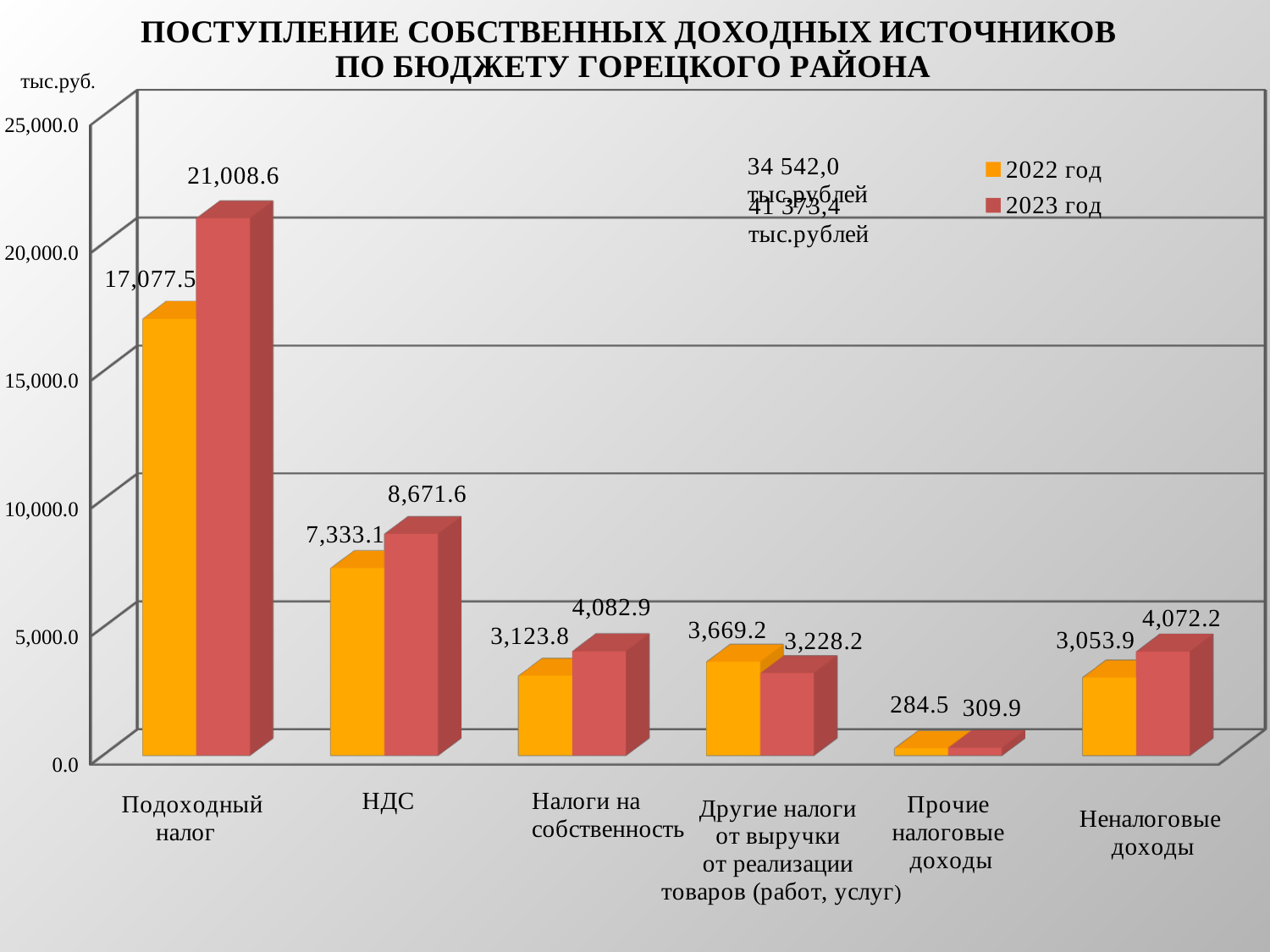
What is the value for Подоходный налог in the 2022 год series? 17,077.5 For Другие налоги от выручки от реализации товаров (работ, услуг), which series has the larger value, 2022 год or 2023 год? 2022 год Which category has the highest value in the 2023 год series? Подоходный налог What is the value for НДС in the 2023 год series? 8,671.6 Which category has the lowest value in the 2022 год series? Прочие налоговые доходы How many series does the legend list? 2 What is the value for Прочие налоговые доходы in the 2022 год series? 284.5 What is the value for Неналоговые доходы in the 2023 год series? 4,072.2 What is the difference between the 2023 год and 2022 год values for Подоходный налог? 3,931.1 How many categories are shown on the x axis? 6 What kind of chart is shown on the slide? Bar chart What is the difference between the 2022 год and 2023 год values for Другие налоги от выручки от реализации товаров (работ, услуг)? 441.0